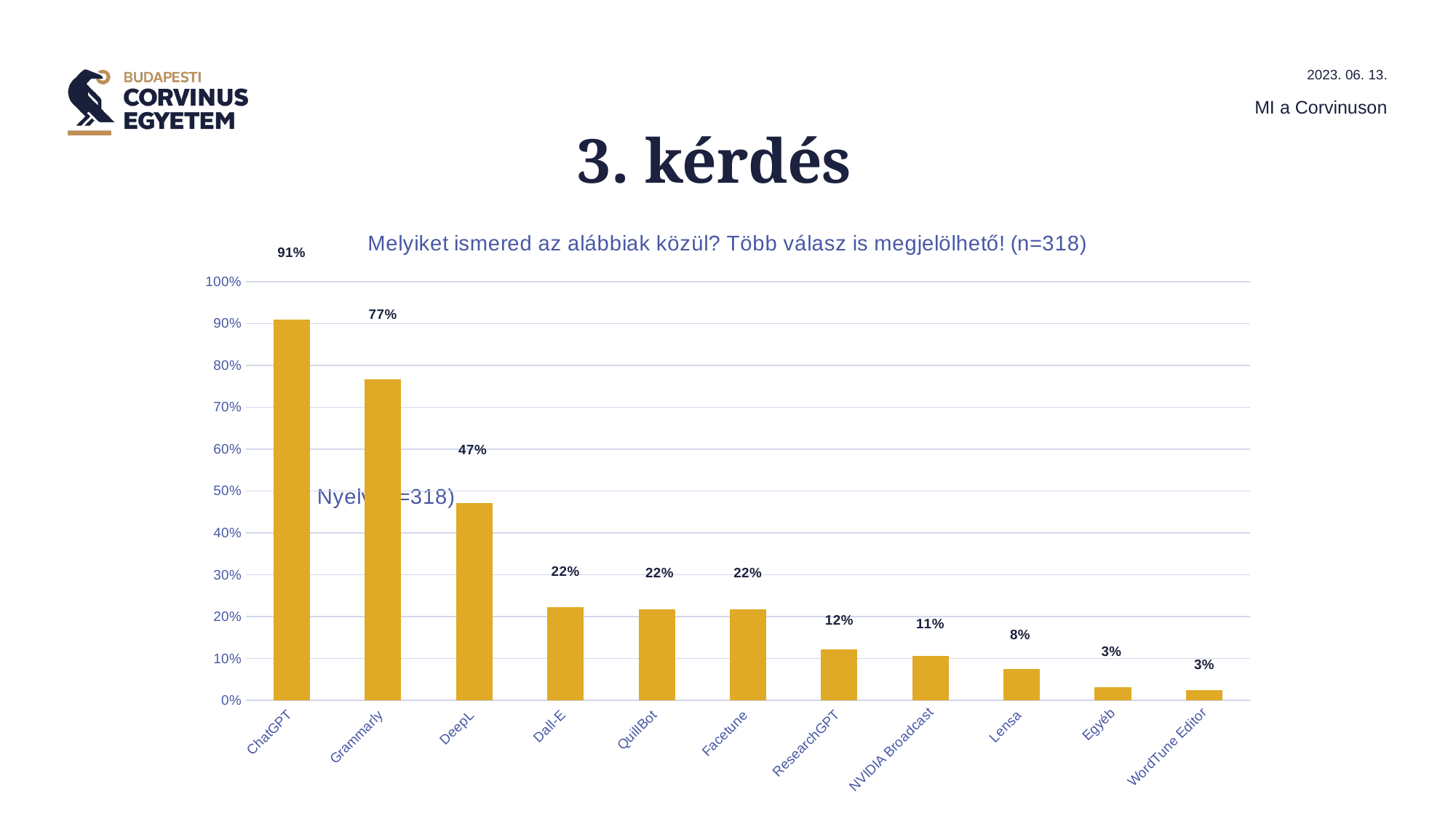
Is the value for NVIDIA Broadcast greater or less than 20%? less What is the value for Grammarly? 77% What is the difference between the values for ChatGPT and Grammarly? 14% How many categories are shown on the x axis? 11 What is the value for Lensa? 8% Which category has the highest value? ChatGPT What is the value for ChatGPT? 91% Do the values rise or fall from left to right along the x axis? fall Which is larger, the value for DeepL or the value for Dall-E? DeepL What is the value for ResearchGPT? 12% What is the value for DeepL? 47% What kind of chart is shown on the slide? bar chart